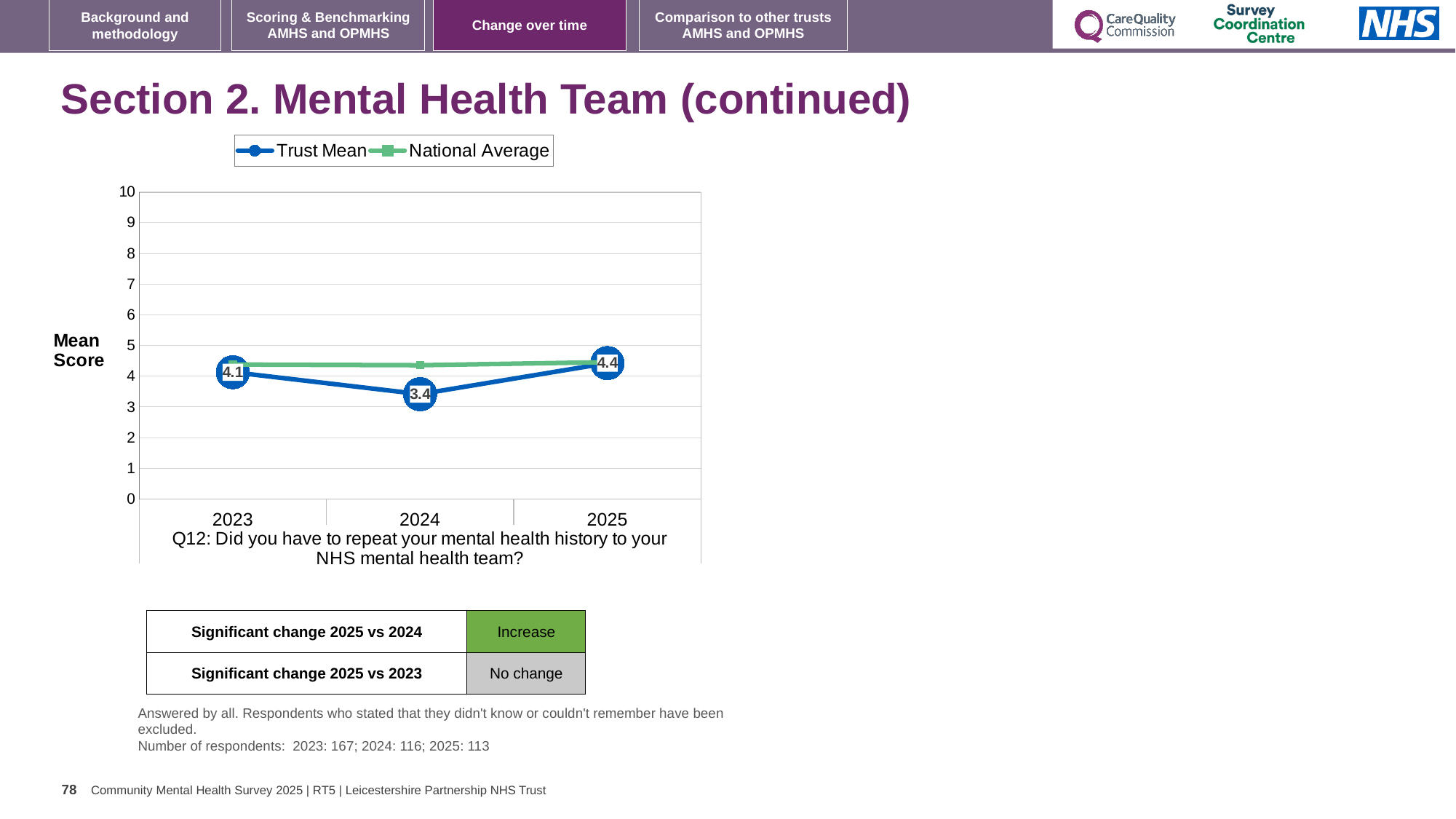
How many series does the legend list? 2 What is the Trust Mean score for 2023? 4.1 How many years are plotted on the x axis? 3 Is the National Average value for 2024 greater or less than 4? greater Does the Trust Mean rise or fall from 2024 to 2025? rise What is the Trust Mean score for 2024? 3.4 What kind of chart is shown on the slide? line chart In which year is the Trust Mean lowest? 2024 Which is larger in 2024, the Trust Mean or the National Average? National Average What is the Trust Mean score for 2025? 4.4 What is the difference between the Trust Mean in 2025 and in 2024? 1.0 In which year is the Trust Mean highest? 2025